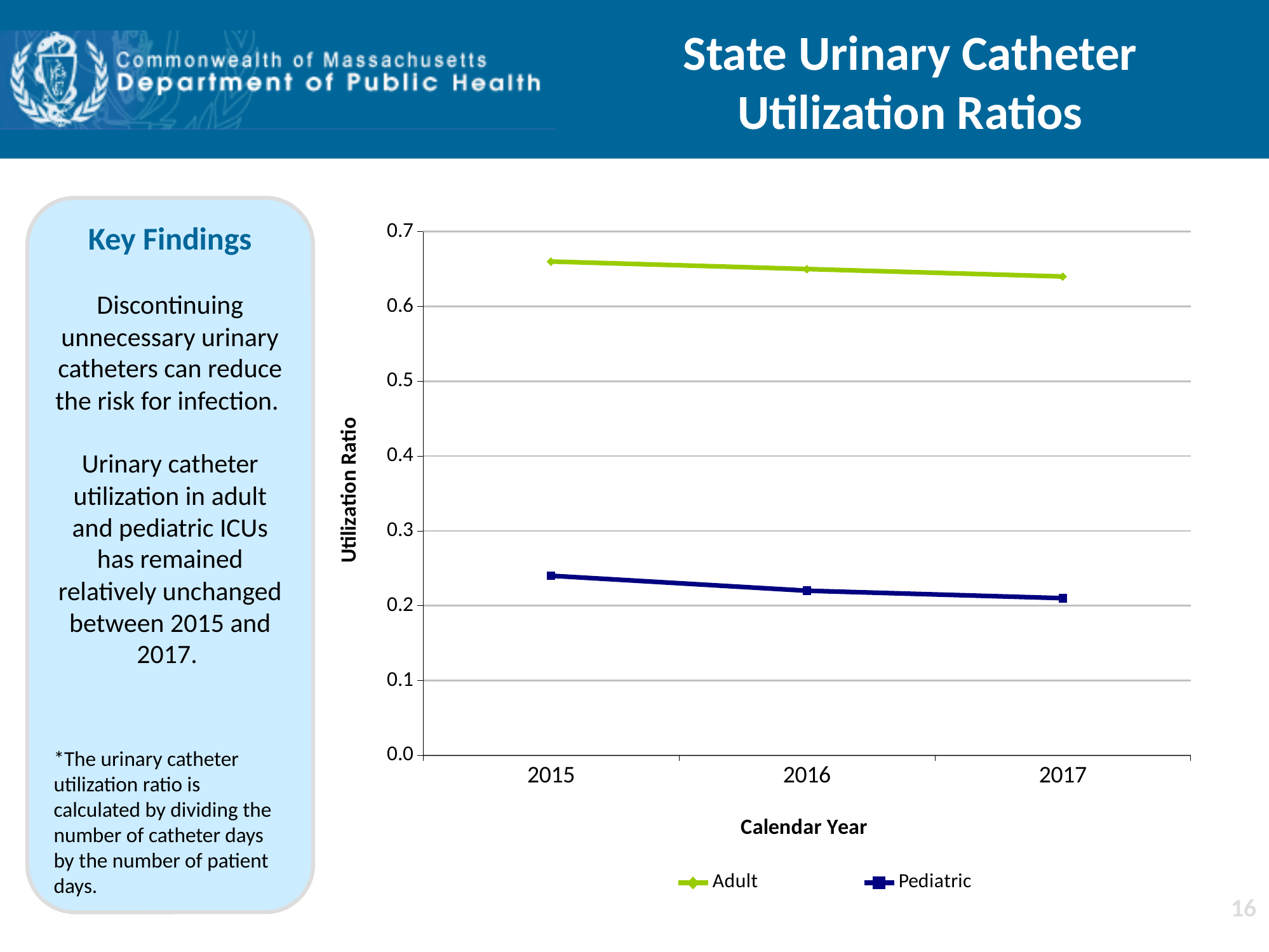
Does the Adult utilization ratio rise or fall from 2015 to 2017? fall What is the title of the chart's y axis? Utilization Ratio What kind of chart is shown on the slide? line chart Which series has the higher utilization ratio in 2016, Adult or Pediatric? Adult Is the Pediatric utilization ratio in 2017 greater or less than 0.3? less What is the title of the chart's x axis? Calendar Year Does the Pediatric utilization ratio rise or fall from 2015 to 2017? fall How many series does the chart's legend list? 2 Is the Pediatric utilization ratio in 2015 greater or less than 0.2? greater Is the Adult utilization ratio in 2017 greater or less than 0.7? less How many calendar years are plotted on the x axis of the chart? 3